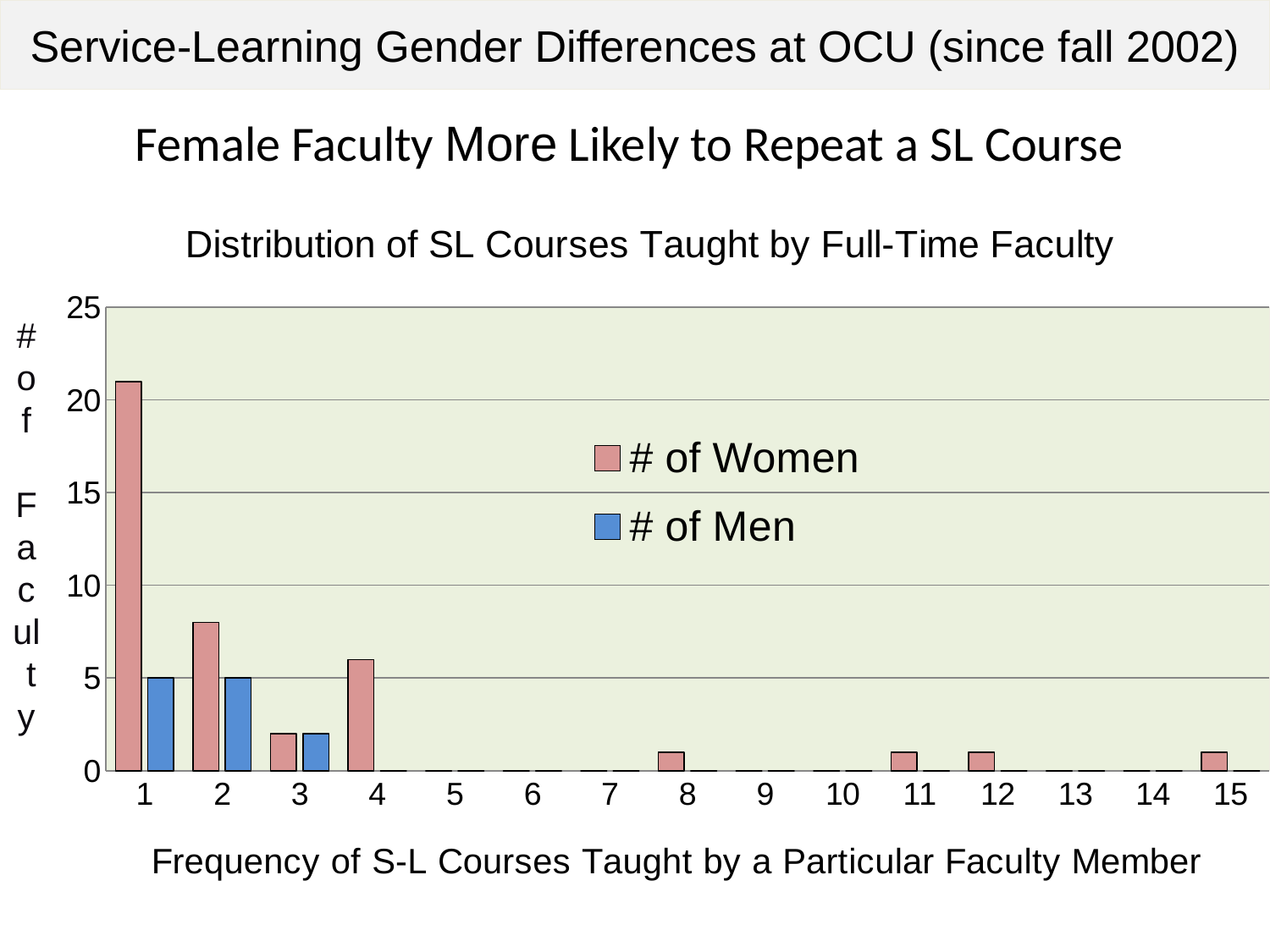
What is the value for # of Men at frequency 2? 5 Is the value for # of Women at frequency 1 greater or less than 20? greater Which frequency category has the highest value for # of Women? 1 Do the values for # of Women generally rise or fall as the frequency increases from 1 to 4? fall How many series does the legend list? 2 What is the value for # of Men at frequency 1? 5 At frequency 1, which is larger: # of Women or # of Men? # of Women What is the title of the chart? Distribution of SL Courses Taught by Full-Time Faculty Is the value for # of Women at frequency 2 greater or less than 10? less What kind of chart is shown on the slide? bar chart How many categories are shown along the x axis? 15 Is the value for # of Women at frequency 4 greater or less than 5? greater